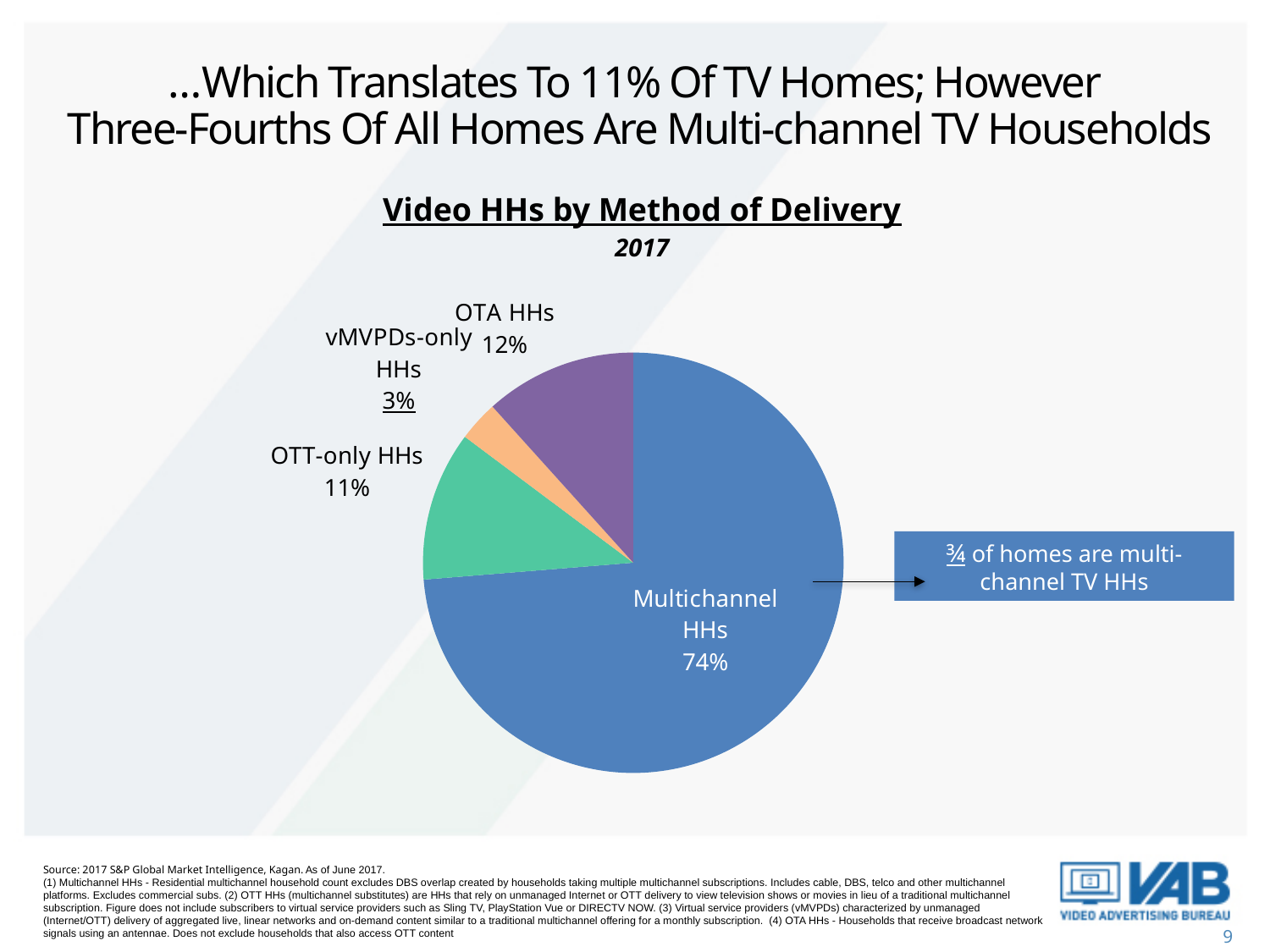
What kind of chart is shown on the slide? Pie chart What year does the chart cover? 2017 What share of Video HHs are OTA HHs? 12% Which category has the largest share of the pie? Multichannel HHs What is the difference in percentage points between OTA HHs and vMVPDs-only HHs? 9 What share of Video HHs are vMVPDs-only HHs? 3% What share of Video HHs are OTT-only HHs? 11% Which is larger, the share for OTA HHs or the share for OTT-only HHs? OTA HHs What is the difference in percentage points between Multichannel HHs and OTT-only HHs? 63 How many categories are shown in the pie chart? 4 Which category has the smallest share of the pie? vMVPDs-only HHs What share of Video HHs are Multichannel HHs? 74%